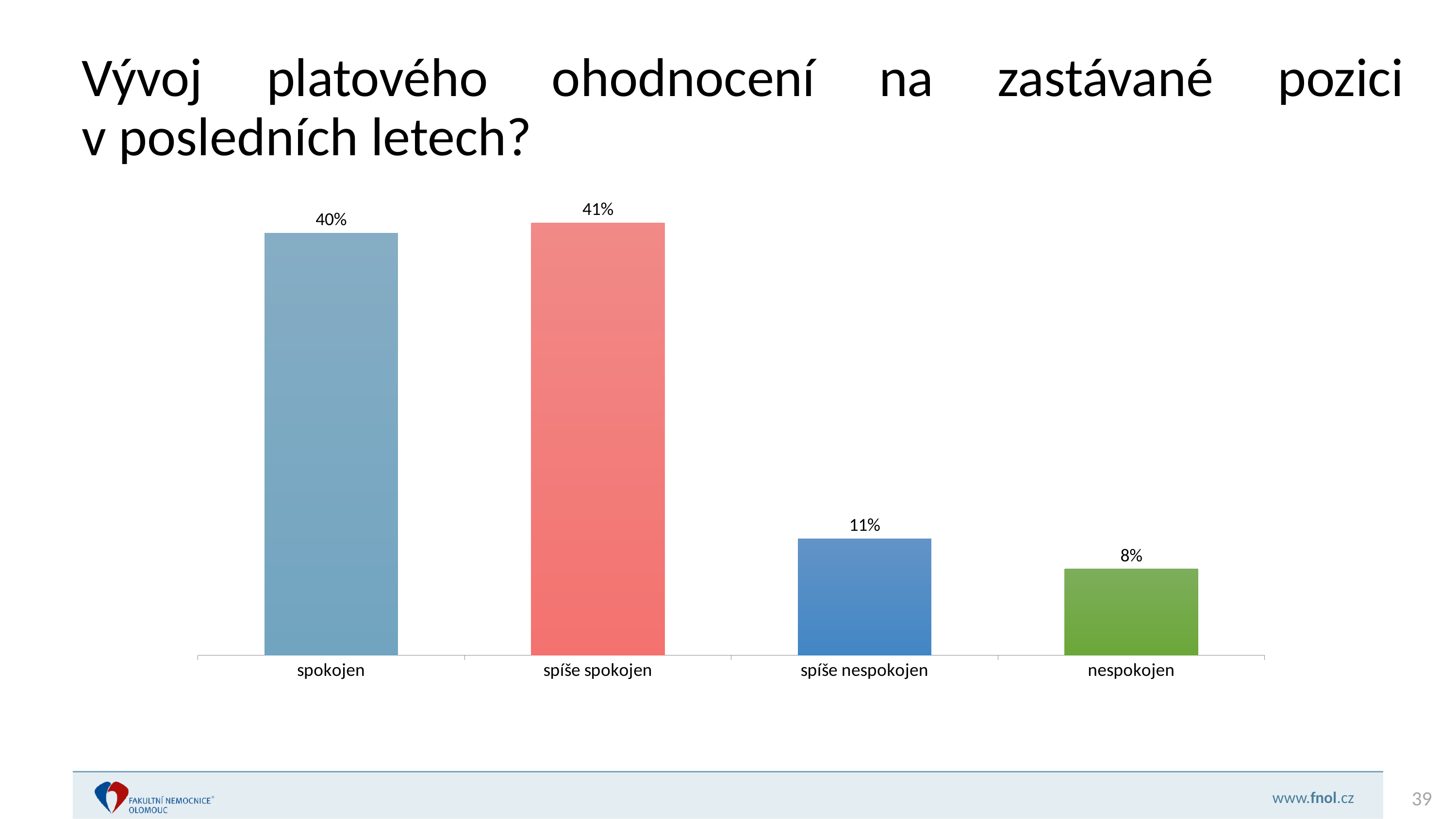
Which category has the lowest value? nespokojen What is the difference between the values for "spíše spokojen" and "spokojen"? 1% Which category has the highest value? spíše spokojen Which is larger, the value for "spokojen" or the value for "spíše nespokojen"? spokojen What is the value for "spokojen"? 40% What is the value for "nespokojen"? 8% What is the value for "spíše spokojen"? 41% How many categories are shown on the x axis? 4 What is the difference between the values for "spíše nespokojen" and "nespokojen"? 3% What colour is the bar for "spíše spokojen"? red What is the value for "spíše nespokojen"? 11% What kind of chart is shown on the slide? bar chart